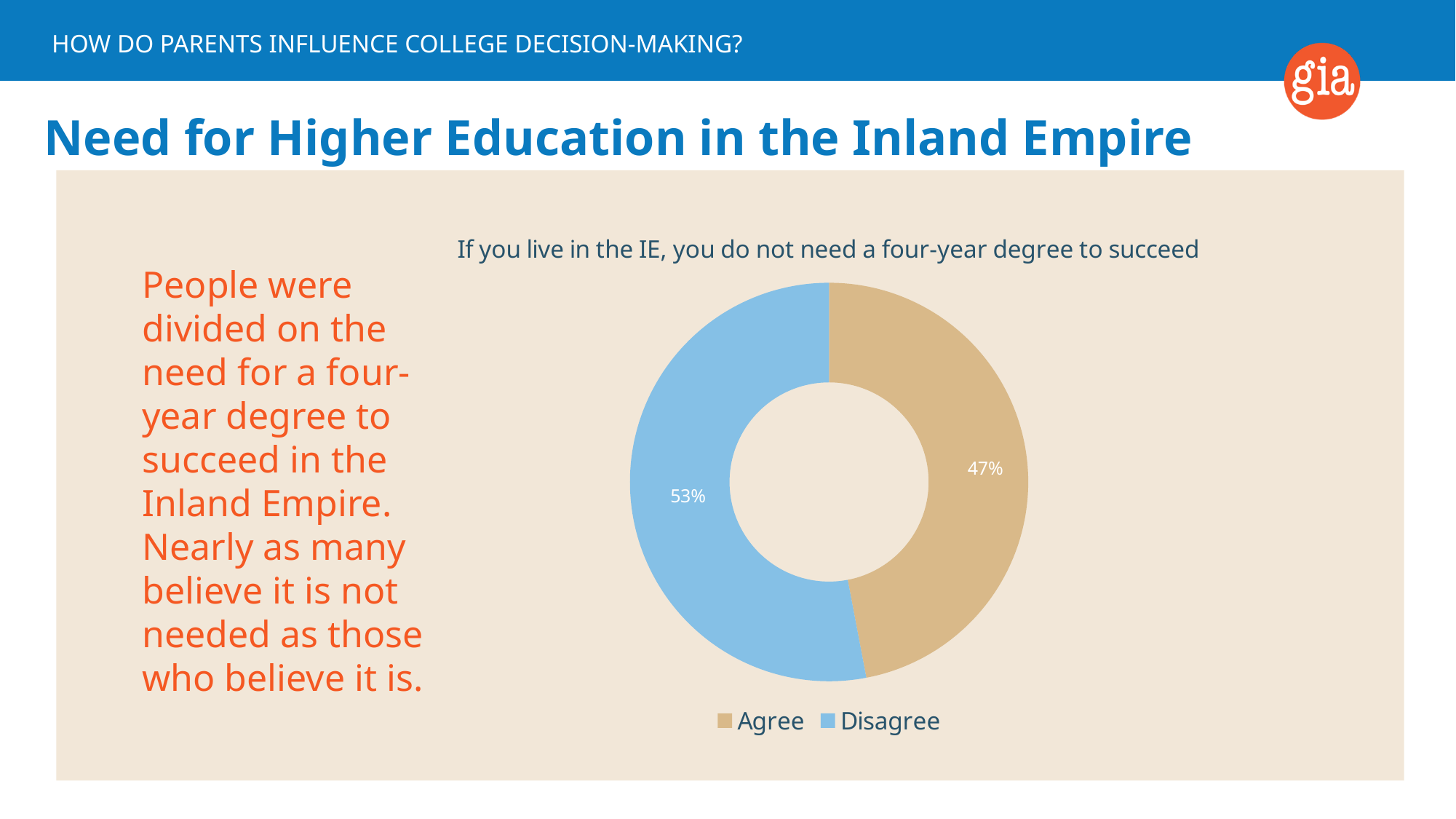
What percentage of respondents disagree with the statement that you do not need a four-year degree to succeed in the IE? 53% How many entries does the chart legend list? 2 Which response has the smaller share of the chart? Agree What kind of chart is shown on the slide? Doughnut (pie) chart How many categories does the chart show? 2 What is the difference in percentage points between the Disagree and Agree shares? 6 percentage points Is the Agree share larger or smaller than the Disagree share? smaller What percentage of respondents agree that if you live in the IE, you do not need a four-year degree to succeed? 47% Which response has the larger share of the chart, Agree or Disagree? Disagree What is the title of the chart? If you live in the IE, you do not need a four-year degree to succeed Is the Agree share greater or less than 50%? less Which colour represents the Disagree category in the chart? Blue